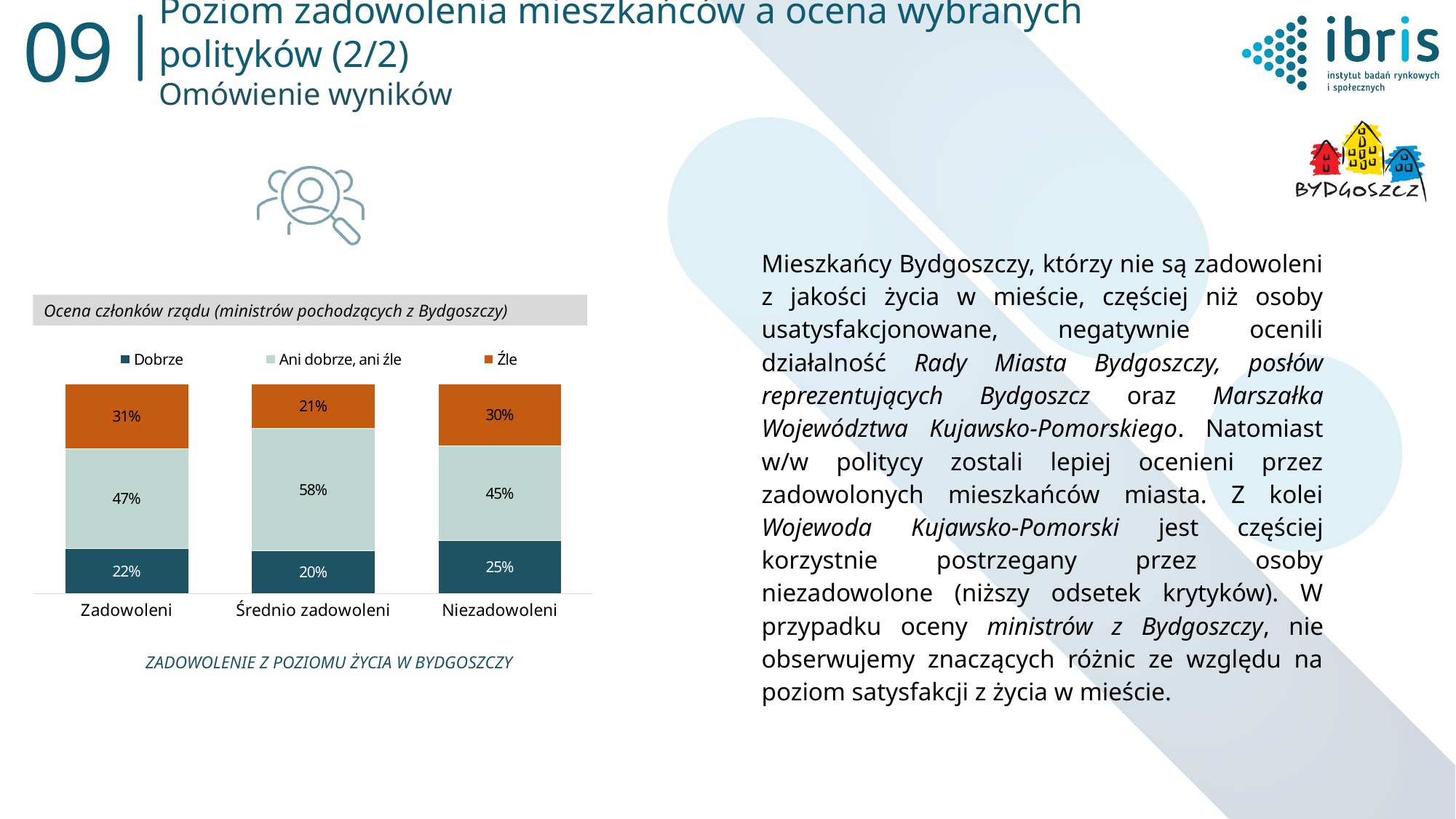
What type of chart is used to show the assessment of government members from Bydgoszcz? Stacked bar chart What percentage of 'Zadowoleni' respondents rated the ministers from Bydgoszcz 'Dobrze'? 22% What is the title of the chart on the slide? Ocena członków rządu (ministrów pochodzących z Bydgoszczy) Which satisfaction group has the highest share of 'Dobrze' ratings? Niezadowoleni What percentage of 'Niezadowoleni' respondents rated the ministers 'Źle'? 30% How many series does the chart legend list? 3 Which satisfaction group has the lowest share of 'Źle' ratings? Średnio zadowoleni What is the difference between the 'Ani dobrze, ani źle' share for 'Średnio zadowoleni' and for 'Niezadowoleni'? 13 percentage points What is the total of the three segments in the 'Zadowoleni' bar? 100% What percentage of 'Średnio zadowoleni' respondents answered 'Ani dobrze, ani źle'? 58% How many satisfaction groups are shown on the x axis of the chart? 3 Which group has a larger 'Źle' share: 'Zadowoleni' or 'Niezadowoleni'? Zadowoleni